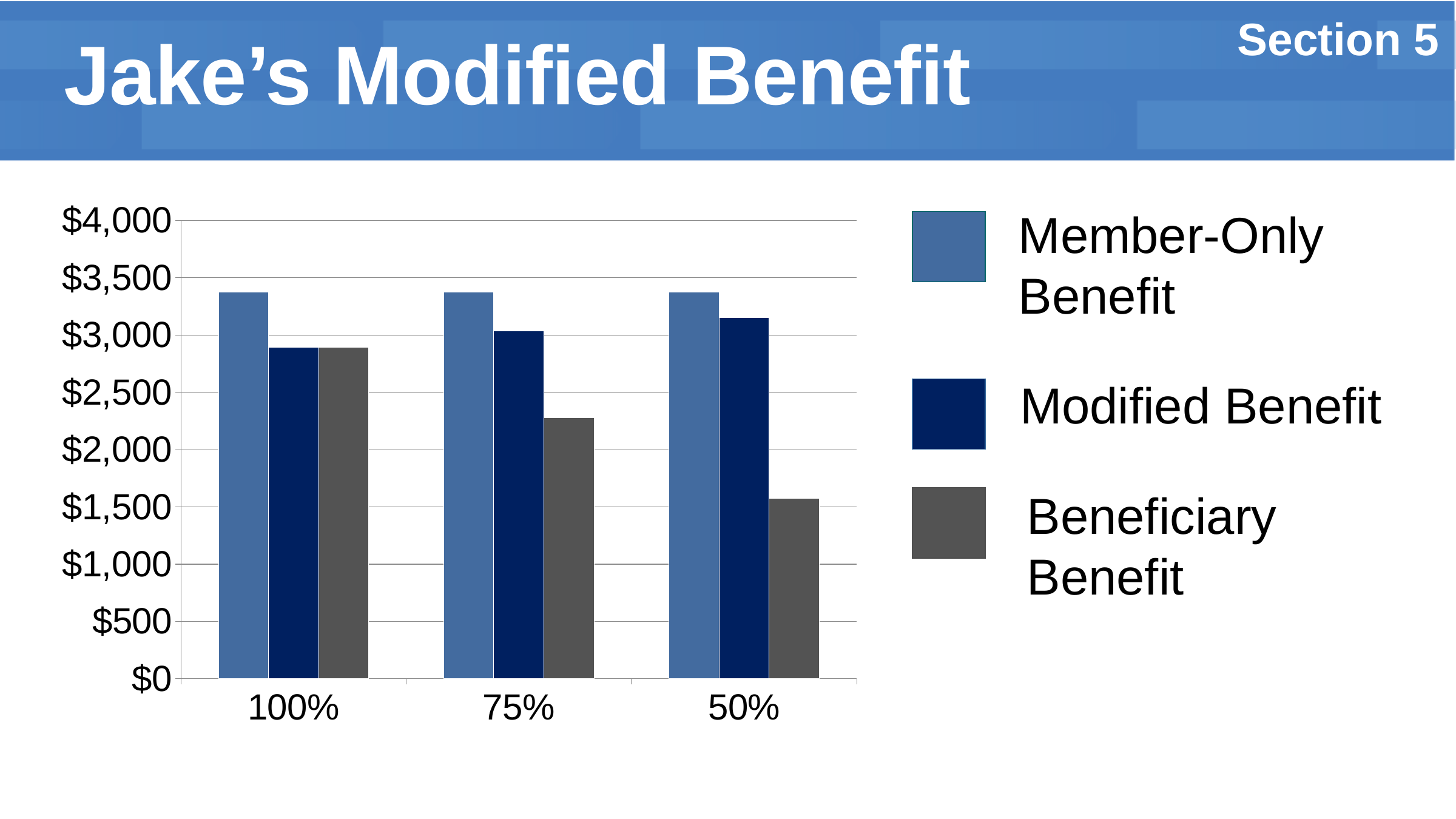
Is the Beneficiary Benefit value for 50% greater or less than $2,000? less Which category has the lowest Beneficiary Benefit value? 50% For the 75% category, which is larger: Member-Only Benefit or Modified Benefit? Member-Only Benefit How many categories are shown on the x axis? 3 Is the Modified Benefit value for 100% greater or less than $3,000? less Is the Member-Only Benefit value for 100% greater or less than $3,000? greater How many series does the legend list? 3 What is the title of the slide containing the chart? Jake's Modified Benefit Do the Beneficiary Benefit values rise or fall moving from 100% to 50% along the x axis? fall For the 50% category, which is larger: Modified Benefit or Beneficiary Benefit? Modified Benefit What kind of chart is shown on the slide? bar chart